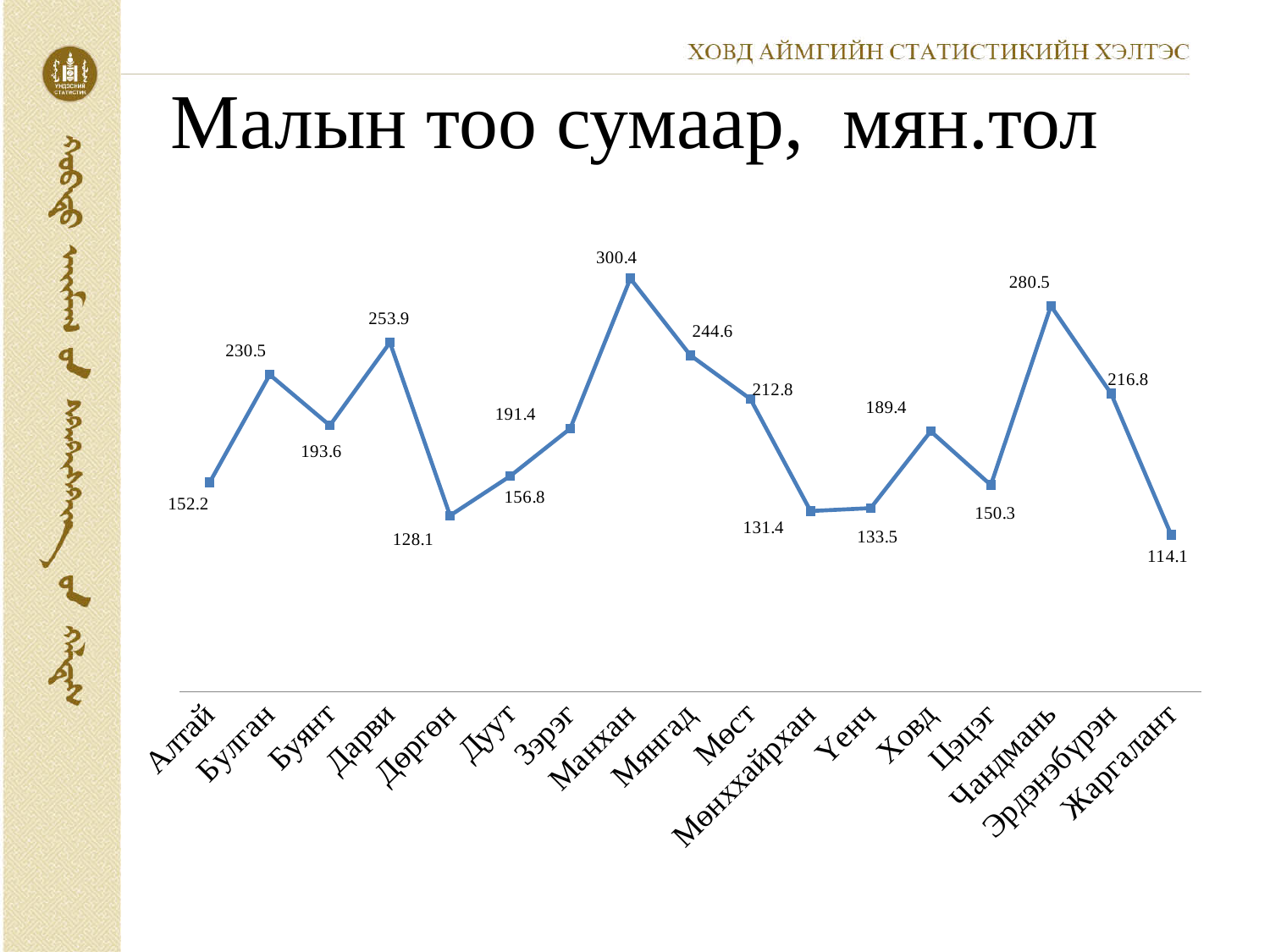
What is the title of the chart? Малын тоо сумаар, мян.тол What is the value for Чандмань? 280.5 Which category has the lowest value? Жаргалант What is the value for Дөргөн? 128.1 What is the value for Жаргалант? 114.1 What is the difference between the values for Манхан and Чандмань? 19.9 What is the difference between the values for Булган and Буянт? 36.9 Which is larger, the value for Мянгад or the value for Мөст? Мянгад How many categories are plotted on the chart? 17 What kind of chart is shown on the slide? Line chart What is the value for Манхан? 300.4 Which category has the highest value? Манхан